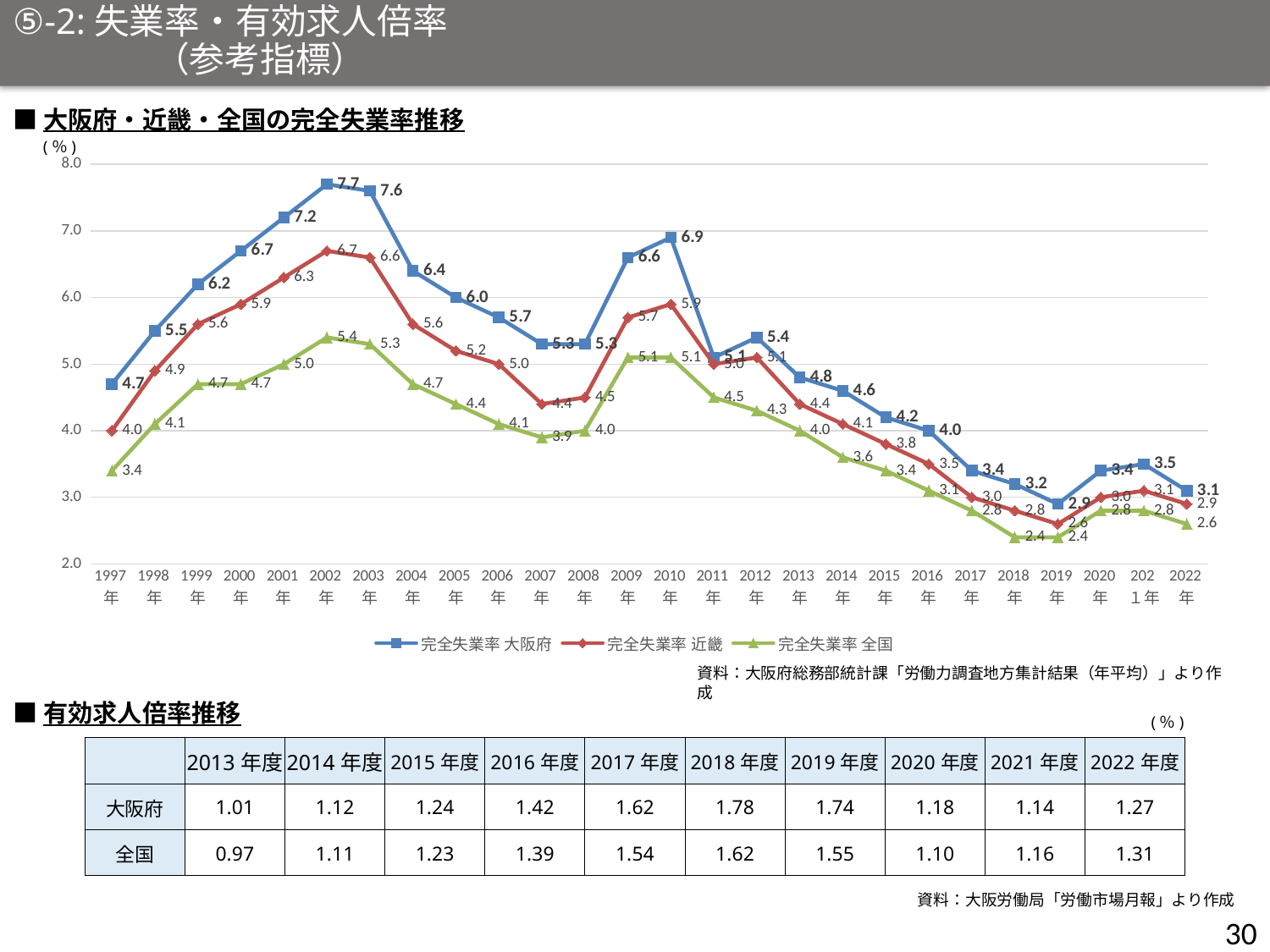
What is the 完全失業率 近畿 value for 2010年 in the unemployment rate chart? 5.9 In which year does the 完全失業率 大阪府 series reach its highest value? 2002年 Does the 完全失業率 大阪府 series rise or fall from 2012年 to 2019年? Fall What is the 完全失業率 大阪府 value for 2002年 in the unemployment rate chart? 7.7 What is the 完全失業率 全国 value for 2018年 in the unemployment rate chart? 2.4 Which series is drawn in green in the unemployment rate chart? 完全失業率 全国 What is the difference between the 完全失業率 大阪府 and 完全失業率 全国 values in 2002年? 2.3 What kind of chart is shown under the heading 大阪府・近畿・全国の完全失業率推移? Line chart Which series has the higher value in 2022年, 完全失業率 大阪府 or 完全失業率 近畿? 完全失業率 大阪府 How many series does the legend of the unemployment rate chart list? 3 How many years are plotted along the x axis of the unemployment rate chart? 26 In which year does the 完全失業率 大阪府 series reach its lowest value? 2019年